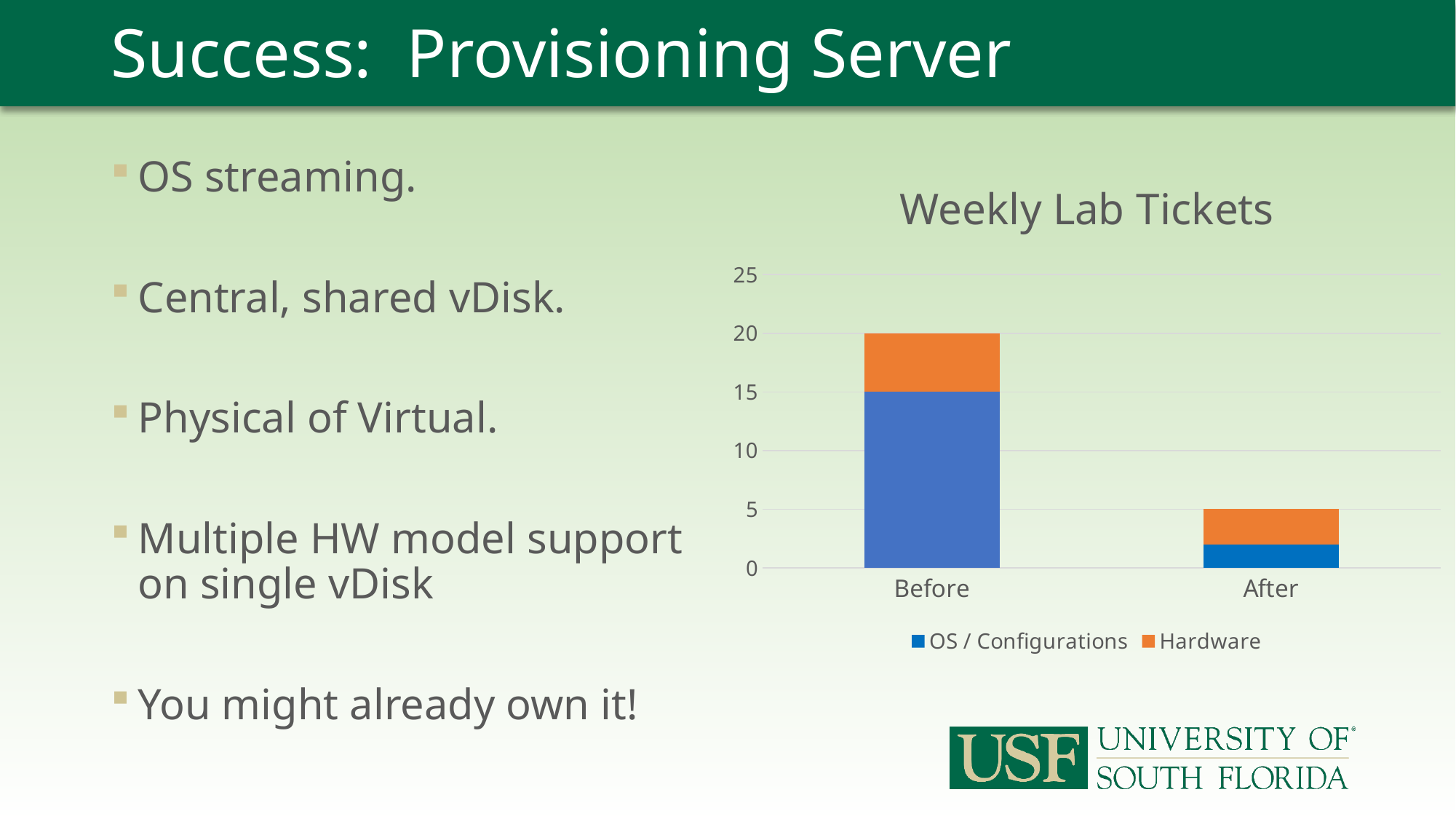
Is the value of OS / Configurations for After greater or less than 5? less How many series does the chart legend list? 2 Which category has the lowest total of weekly lab tickets? After Which category has the higher total of weekly lab tickets, Before or After? Before What is the difference between the total for Before and the total for After? 15 Which series is shown in orange in the chart? Hardware How many categories are shown on the x axis of the chart? 2 What is the value of OS / Configurations for Before? 15 What is the total height of the stacked bar for After? 5 What kind of chart is shown on the slide? stacked bar chart What is the title of the chart? Weekly Lab Tickets What is the total height of the stacked bar for Before? 20